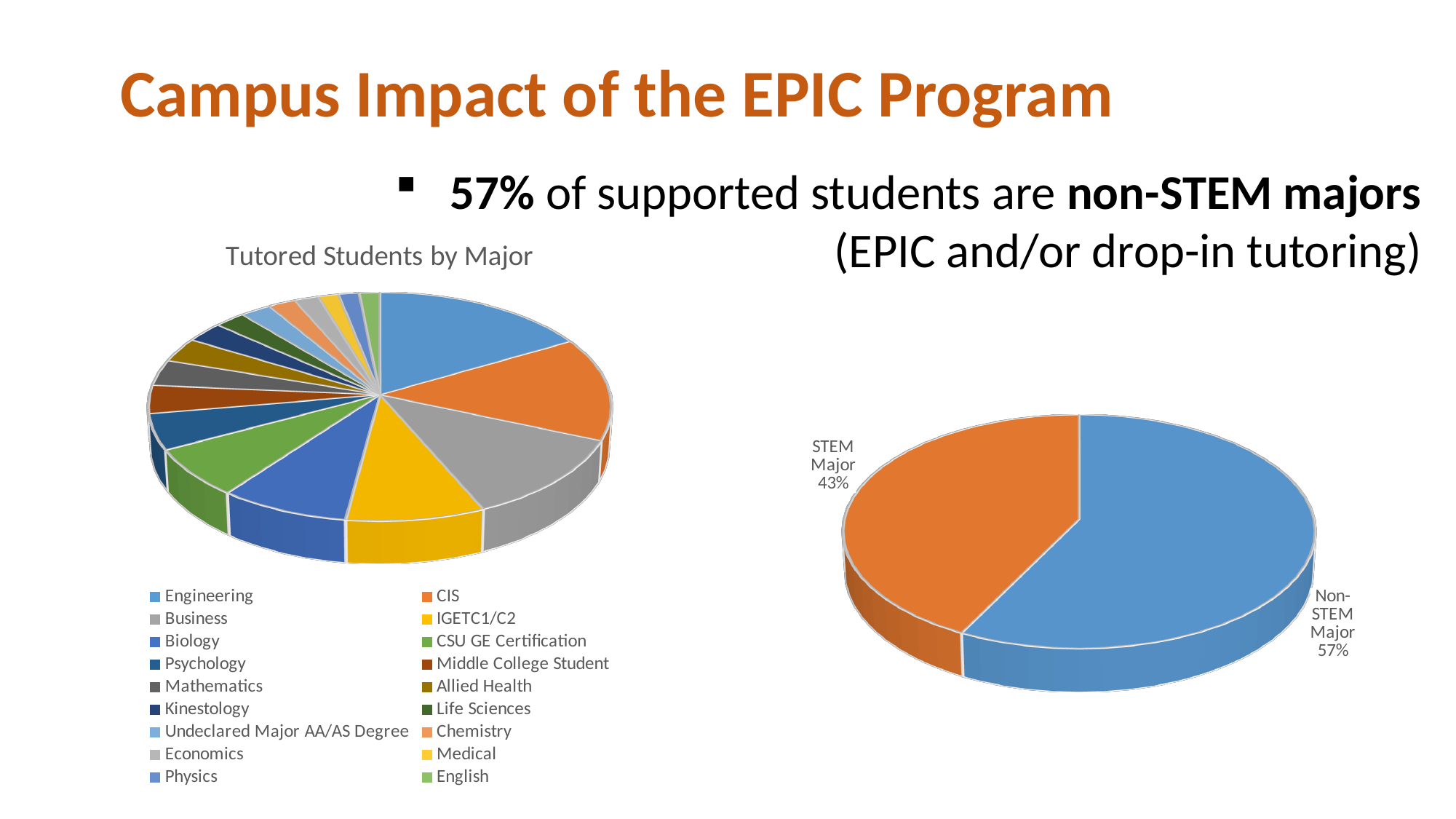
How many majors does the legend of the 'Tutored Students by Major' chart list? 18 In the 'Tutored Students by Major' chart, what colour is the Engineering slice? Blue On the right pie chart, what share of supported students are STEM Majors? 43% On the right pie chart, what is the difference in percentage points between the Non-STEM Major and STEM Major slices? 14 percentage points How many slices does the right pie chart have? 2 On the right pie chart, what share of supported students are Non-STEM Majors? 57% What is the title of the chart on the left of the slide? Tutored Students by Major What kind of chart is 'Tutored Students by Major'? Pie chart In the 'Tutored Students by Major' chart, which slice is larger, Engineering or Psychology? Engineering On the right pie chart, which slice is larger, STEM Major or Non-STEM Major? Non-STEM Major In the 'Tutored Students by Major' chart, which major has the largest slice? Engineering What kind of chart is the chart on the right of the slide? Pie chart